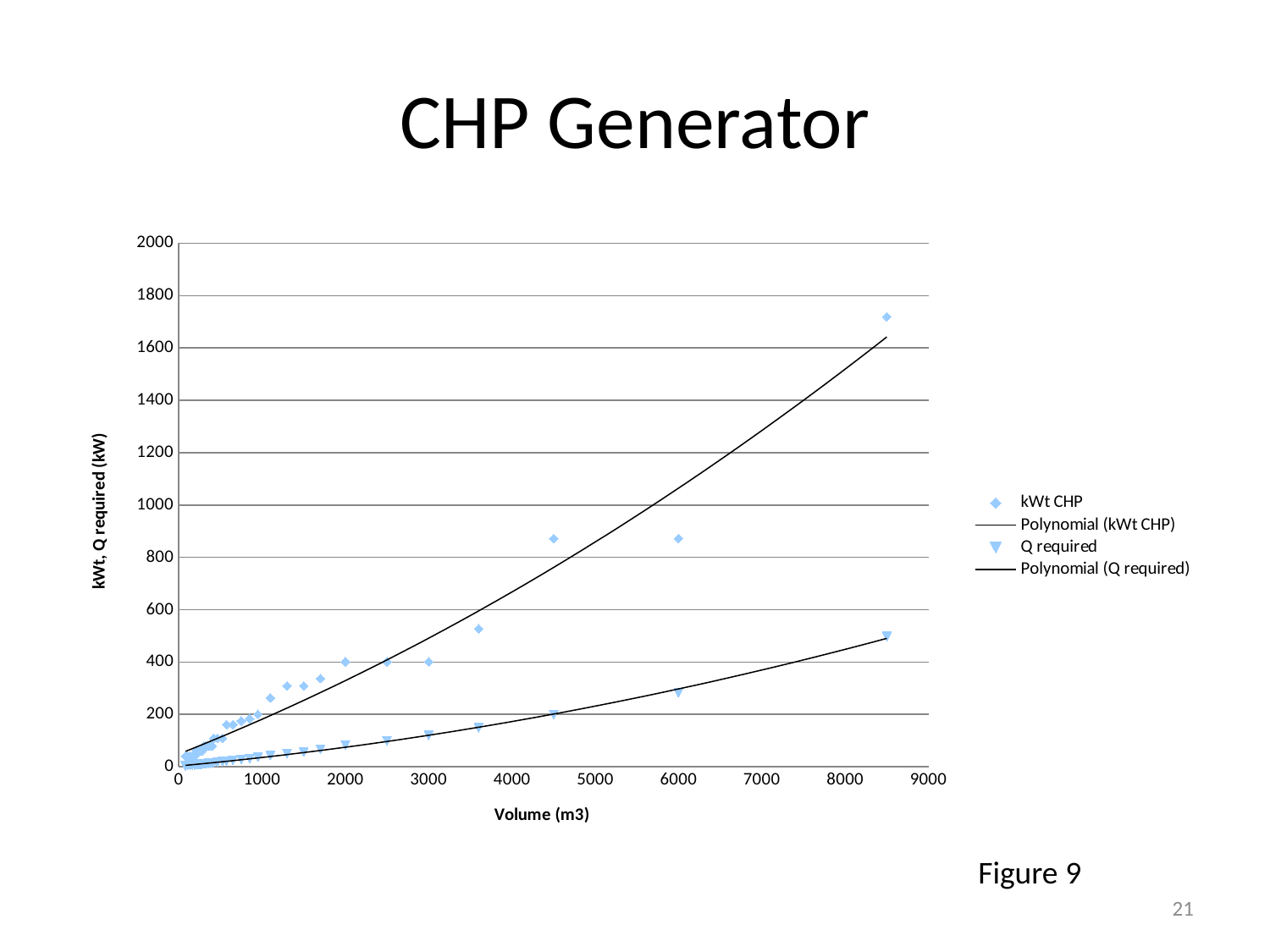
What is the label of the x axis? Volume (m3) Is the highest kWt CHP value greater or less than 1600? greater How many entries does the chart legend list? 4 Which series reaches the highest value on the chart? kWt CHP Do the Q required values rise or fall as volume increases? rise At a volume of 6000, which series has the larger value, kWt CHP or Q required? kWt CHP Is the highest Q required value greater or less than 600? less Is the kWt CHP value at a volume of 6000 greater or less than 800? greater What is the title of the chart on the slide? CHP Generator Do the kWt CHP values rise or fall as volume increases? rise What kind of chart is shown on the slide? scatter chart